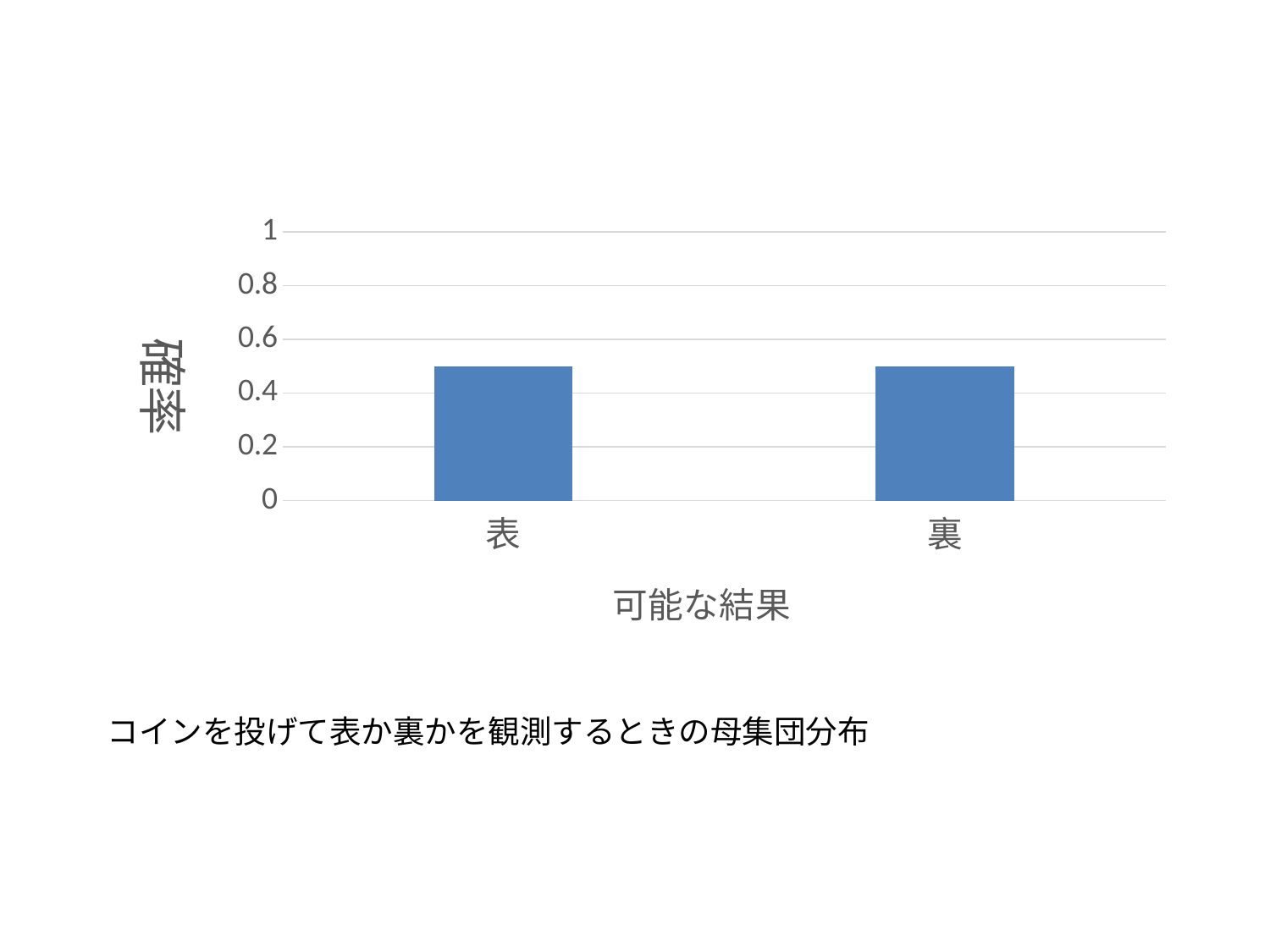
Is the value for 表 greater or less than 0.4? greater What is the label of the vertical axis of the chart? 確率 Do the bar values rise, fall, or stay the same from 表 to 裏? stay the same Is the value for 裏 greater or less than 0.4? greater Is the value for 表 greater or less than 0.6? less How many categories are shown on the x axis of the chart? 2 What is the label of the horizontal axis of the chart? 可能な結果 What kind of chart is shown on the slide? bar chart